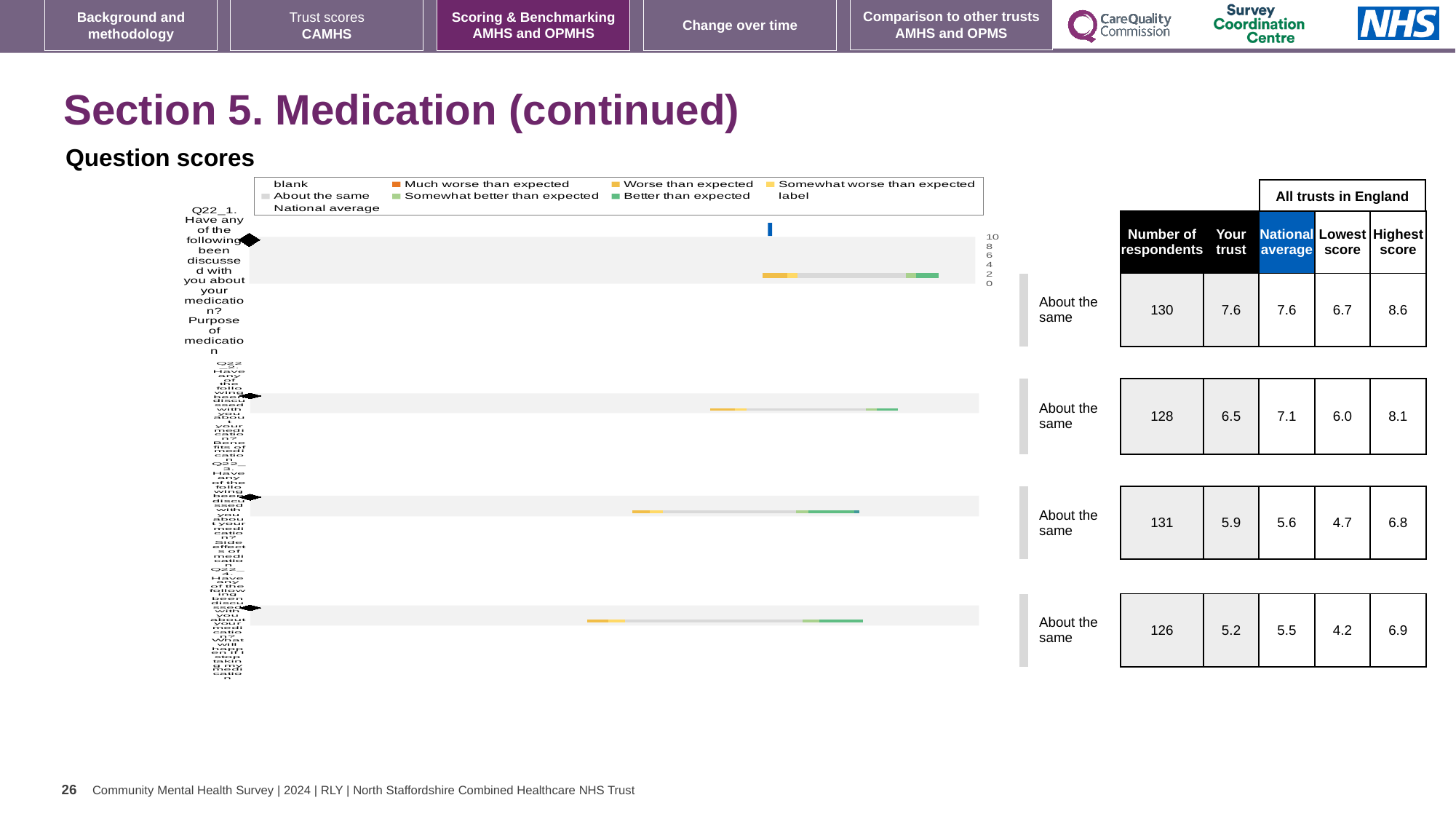
Which question row has the lowest 'Your trust' score in the question scores chart? Q22_4 (the fourth row) In the question scores chart, what is the highest score across all trusts in England for the fourth question row (Q22_4)? 6.9 For Q22_1 (Purpose of medication), what is the difference between the highest score and the lowest score across all trusts in England? 1.9 In the question scores chart, what is the national average for the second question row (Q22_2)? 7.1 In the question scores chart, what is the 'Your trust' score for Q22_1 (Purpose of medication)? 7.6 What benchmark category label is shown next to each of the four question rows in the chart? About the same For the third question row (Q22_3), which is larger: the 'Your trust' score or the national average? Your trust How many question rows (bars) are plotted in the question scores chart? 4 What kind of chart is used to show the question scores on this slide? bar chart Which question row has the highest 'Your trust' score in the question scores chart? Q22_1 (Purpose of medication) In the question scores chart, how many respondents are listed for Q22_1 (Purpose of medication)? 130 In the question scores chart, what is the lowest score across all trusts in England for the third question row (Q22_3)? 4.7